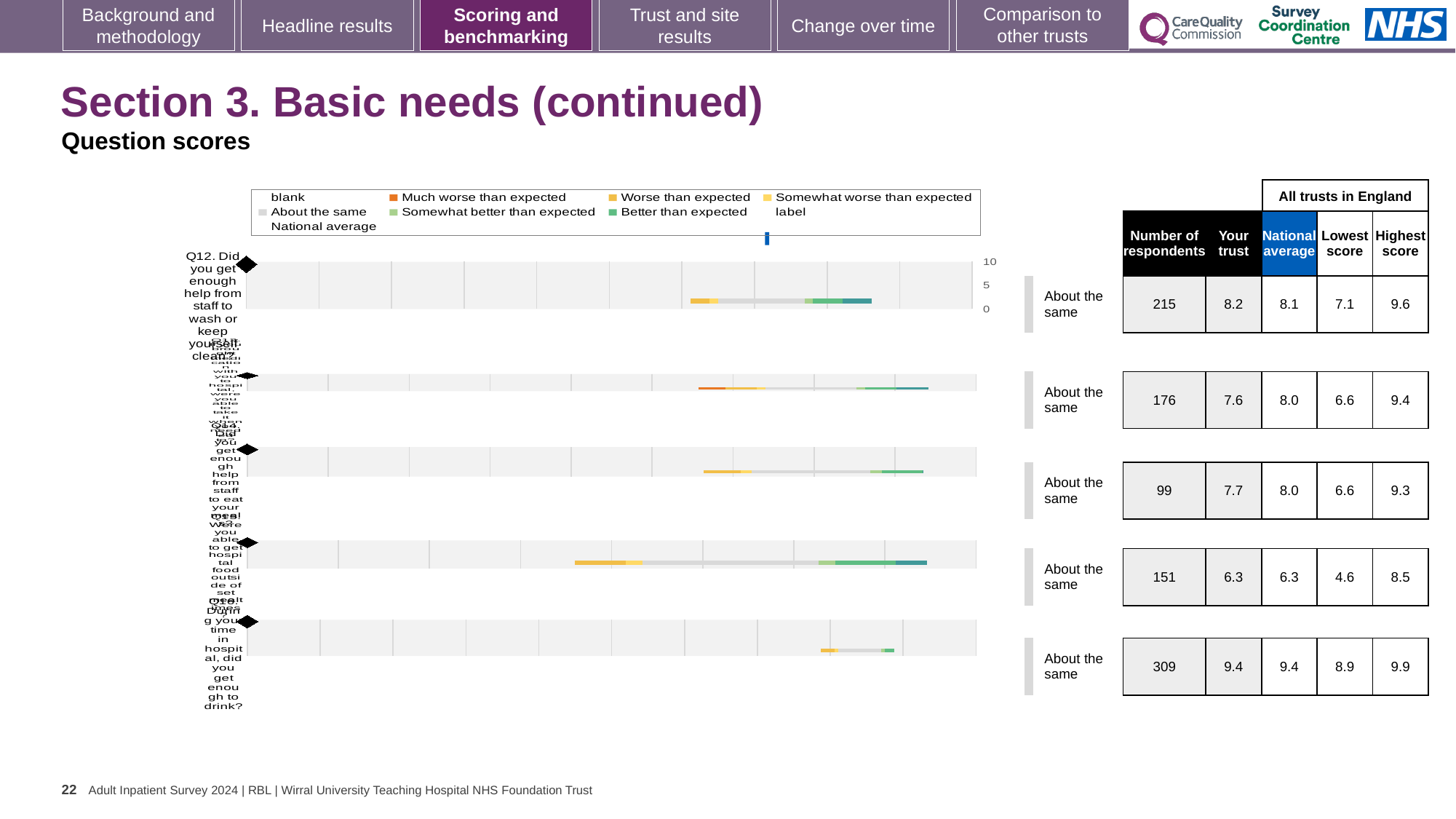
What kind of chart is shown on the slide? bar chart Which legend entry is shown in light grey? About the same In the table beside the chart, which row has the lowest 'Your trust' score? the fourth row, 6.3 In the table beside the chart, what is the 'Your trust' score for the first row (Q12, help from staff to wash or keep yourself clean)? 8.2 In the table beside the chart, what is the national average for the last row (did you get enough to drink)? 9.4 In the table beside the chart, what is the number of respondents for the first row (Q12)? 215 In the table beside the chart, what is the difference between the highest score and the lowest score for the first row (Q12)? 2.5 Which legend entry is shown in orange? Much worse than expected What benchmark category label is shown next to every row of the chart? About the same In the table beside the chart, which row has the highest 'Your trust' score? the last row (did you get enough to drink), 9.4 How many question rows (bars) are plotted in the chart? 5 How many entries does the chart legend list? 9